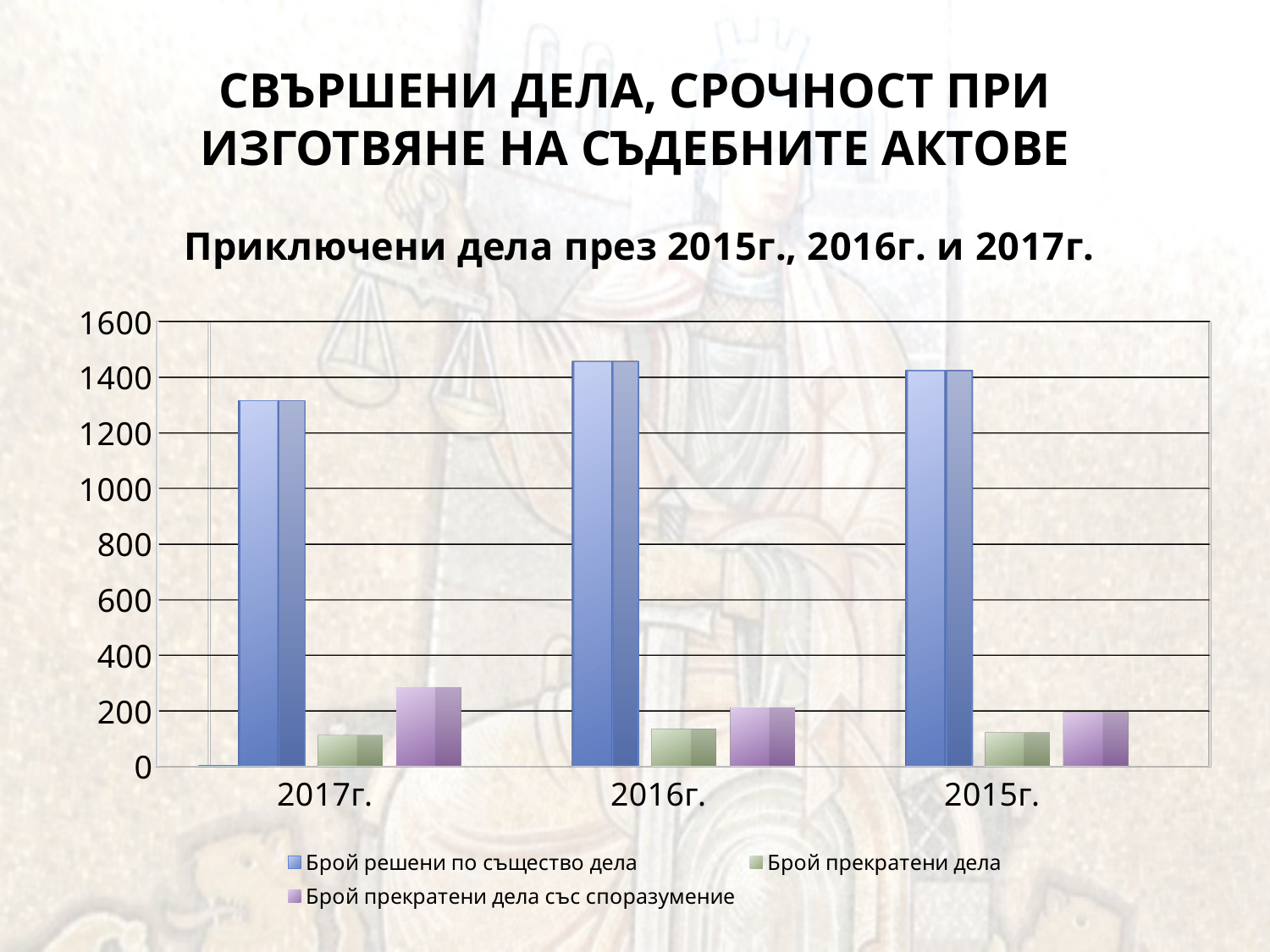
Is the value for 'Брой решени по същество дела' in 2017г. greater or less than 1200? greater Is the value for 'Брой решени по същество дела' in 2016г. greater or less than 1400? greater Is the value for 'Брой прекратени дела' in 2017г. greater or less than 200? less In 2017г., which is larger: 'Брой прекратени дела' or 'Брой прекратени дела със споразумение'? Брой прекратени дела със споразумение What kind of chart is shown on the slide? bar chart How many series does the chart legend list? 3 What is the title of the chart? Приключени дела през 2015г., 2016г. и 2017г. In which year is the value for 'Брой решени по същество дела' the lowest? 2017г. How many years (categories) are shown on the x axis of the chart? 3 In which year is the value for 'Брой прекратени дела със споразумение' the highest? 2017г.